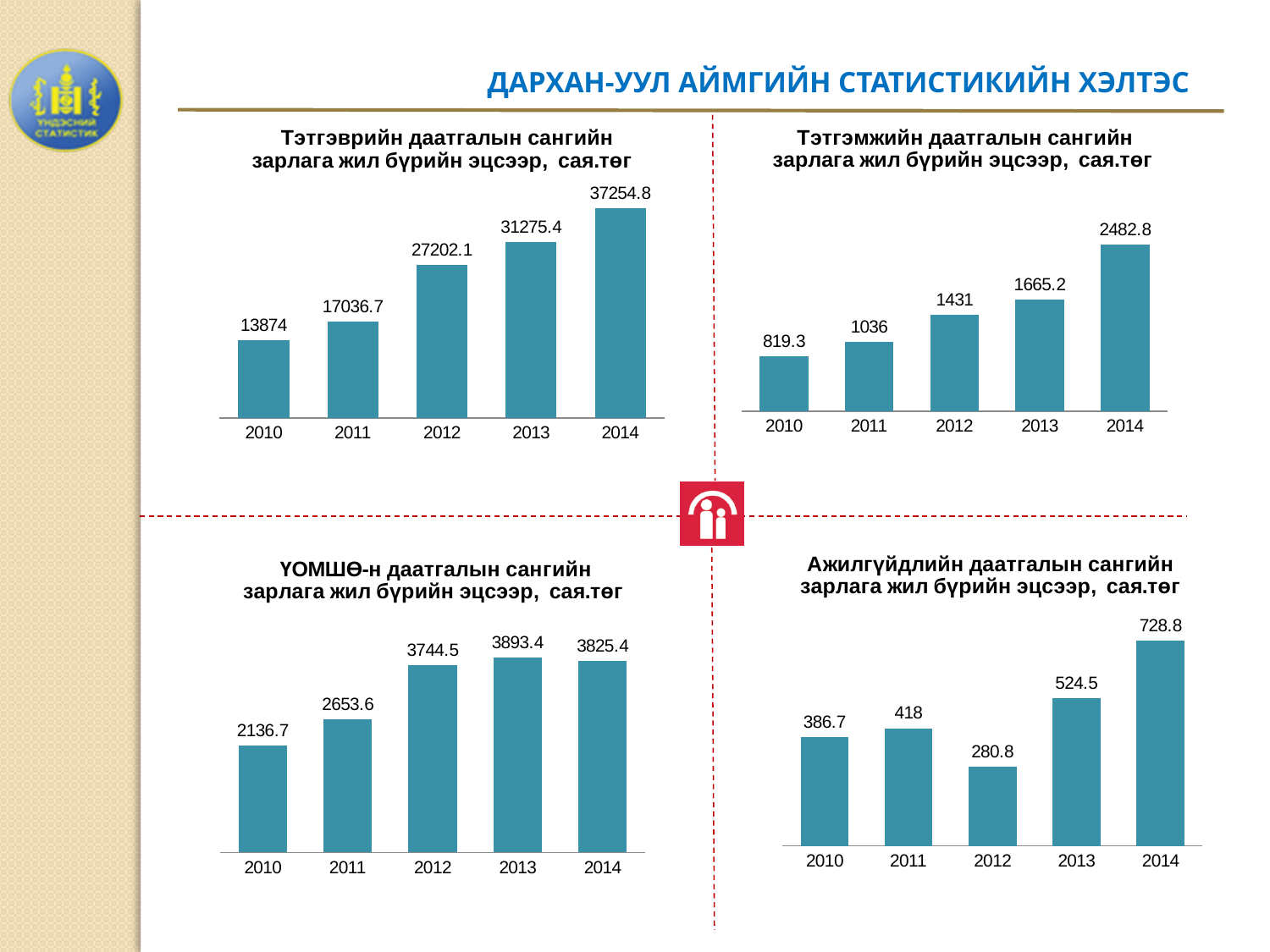
In the top-right chart (Тэтгэмжийн даатгалын сангийн зарлага), which year has the lowest value? 2010 In the bottom-left chart (ҮОМШӨ-н даатгалын сангийн зарлага), which year has the highest value? 2013 In the top-left chart (Тэтгэврийн даатгалын сангийн зарлага), what is the difference between the 2014 and 2013 values? 5979.4 In the top-right chart (Тэтгэмжийн даатгалын сангийн зарлага), do the values rise or fall from 2010 to 2014? rise In the bottom-right chart (Ажилгүйдлийн даатгалын сангийн зарлага), which is larger, the value for 2010 or the value for 2011? 2011 How many years are shown on the x axis of the bottom-left chart (ҮОМШӨ-н даатгалын сангийн зарлага)? 5 In the bottom-right chart (Ажилгүйдлийн даатгалын сангийн зарлага), what is the value for 2014? 728.8 In the top-right chart (Тэтгэмжийн даатгалын сангийн зарлага), what is the value for 2012? 1431 In the bottom-right chart (Ажилгүйдлийн даатгалын сангийн зарлага), which year has the lowest value? 2012 In the bottom-left chart (ҮОМШӨ-н даатгалын сангийн зарлага), what is the value for 2011? 2653.6 In the top-left chart (Тэтгэврийн даатгалын сангийн зарлага), what is the value for 2014? 37254.8 In the top-left chart (Тэтгэврийн даатгалын сангийн зарлага), what is the value for 2010? 13874